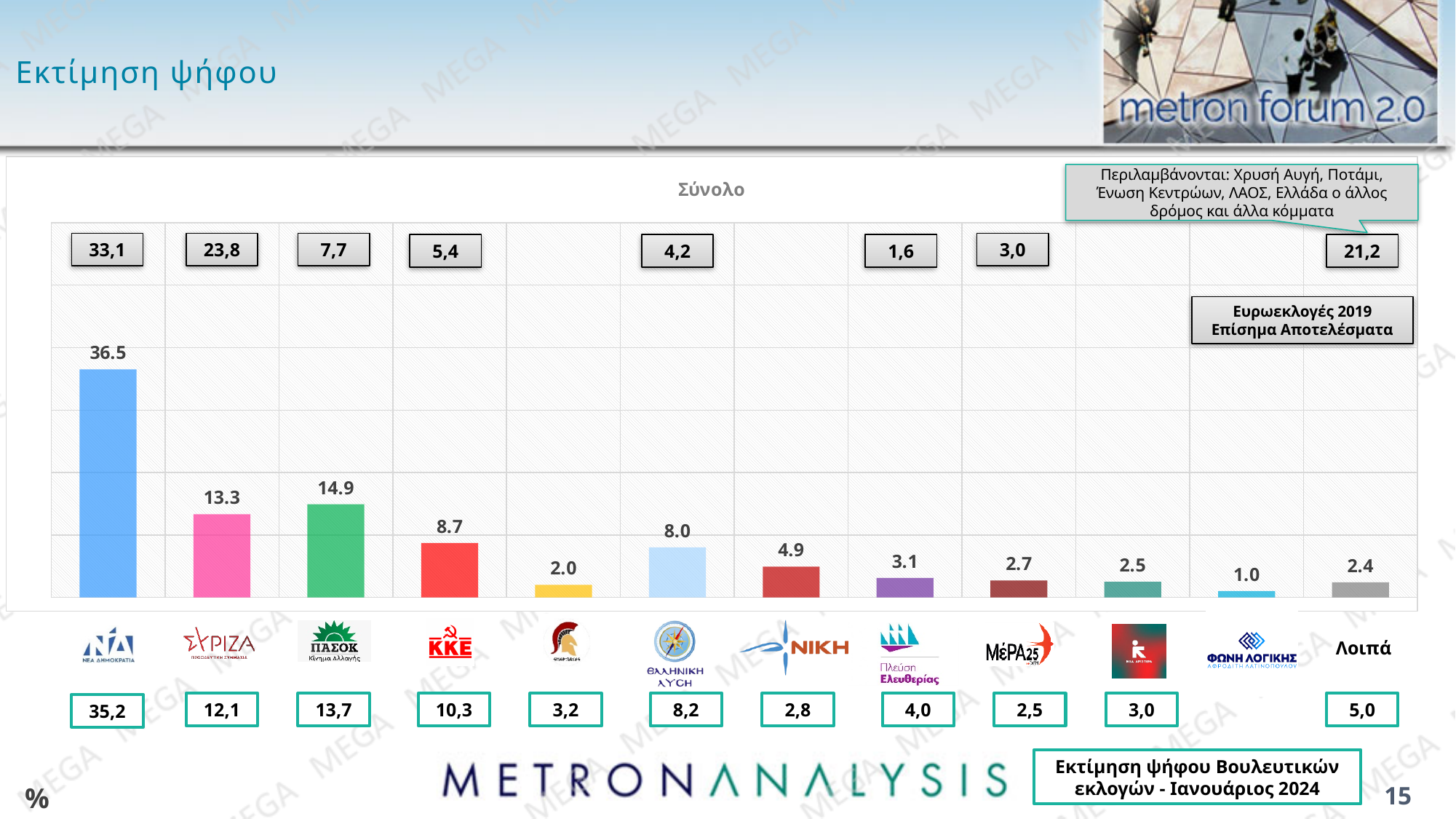
Which category has the lowest bar in the Σύνολο chart? Φωνή Λογικής What is the value of the bar for ΝΕΑ ΔΗΜΟΚΡΑΤΙΑ in the Σύνολο chart? 36.5 What is the value of the bar for ΠΑΣΟΚ in the Σύνολο chart? 14.9 What is the difference between the bar values for ΝΕΑ ΔΗΜΟΚΡΑΤΙΑ and ΠΑΣΟΚ in the Σύνολο chart? 21.6 How many bars are plotted in the Σύνολο chart? 12 What is the value of the bar for ΚΚΕ in the Σύνολο chart? 8.7 What is the value of the bar for Λοιπά in the Σύνολο chart? 2.4 What is the value of the bar for ΝΙΚΗ in the Σύνολο chart? 4.9 Which bar is larger in the Σύνολο chart, ΣΥΡΙΖΑ or ΠΑΣΟΚ? ΠΑΣΟΚ What is the title of the chart on the slide? Σύνολο What kind of chart is shown on the slide? Bar chart Which category has the highest bar in the Σύνολο chart? ΝΕΑ ΔΗΜΟΚΡΑΤΙΑ